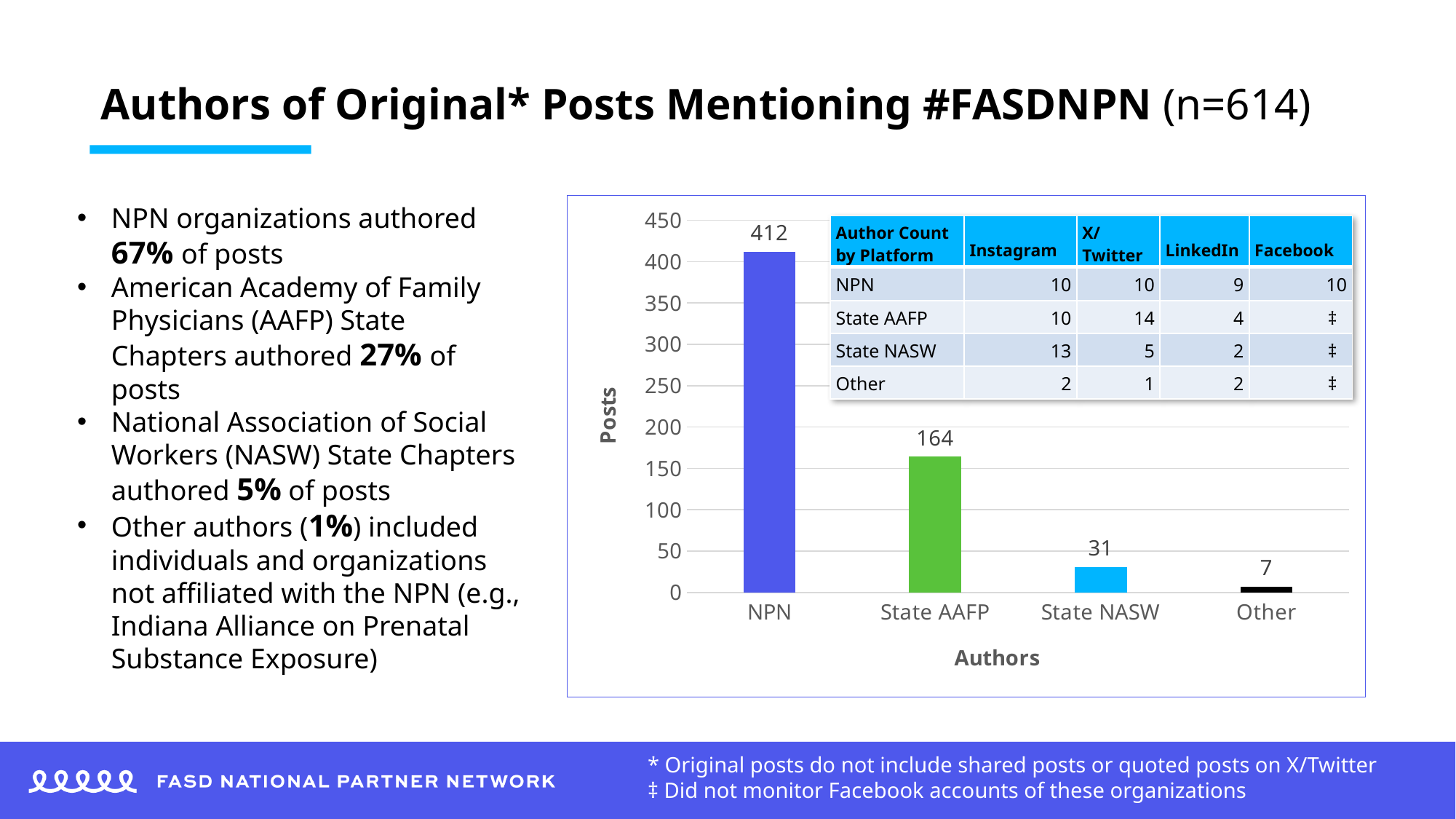
How many author categories are shown on the x axis of the chart? 4 How many posts were authored by State NASW? 31 Which has more posts, State AAFP or State NASW? State AAFP What is the difference in posts between State NASW and Other? 24 How many posts were authored by State AAFP? 164 What is the difference in posts between NPN and State AAFP? 248 How many posts were authored by NPN? 412 What is the label of the y axis of the chart? Posts Which author category has the lowest number of posts? Other Which author category has the highest number of posts? NPN What type of chart is shown on the slide? Bar chart How many posts were authored by Other authors? 7